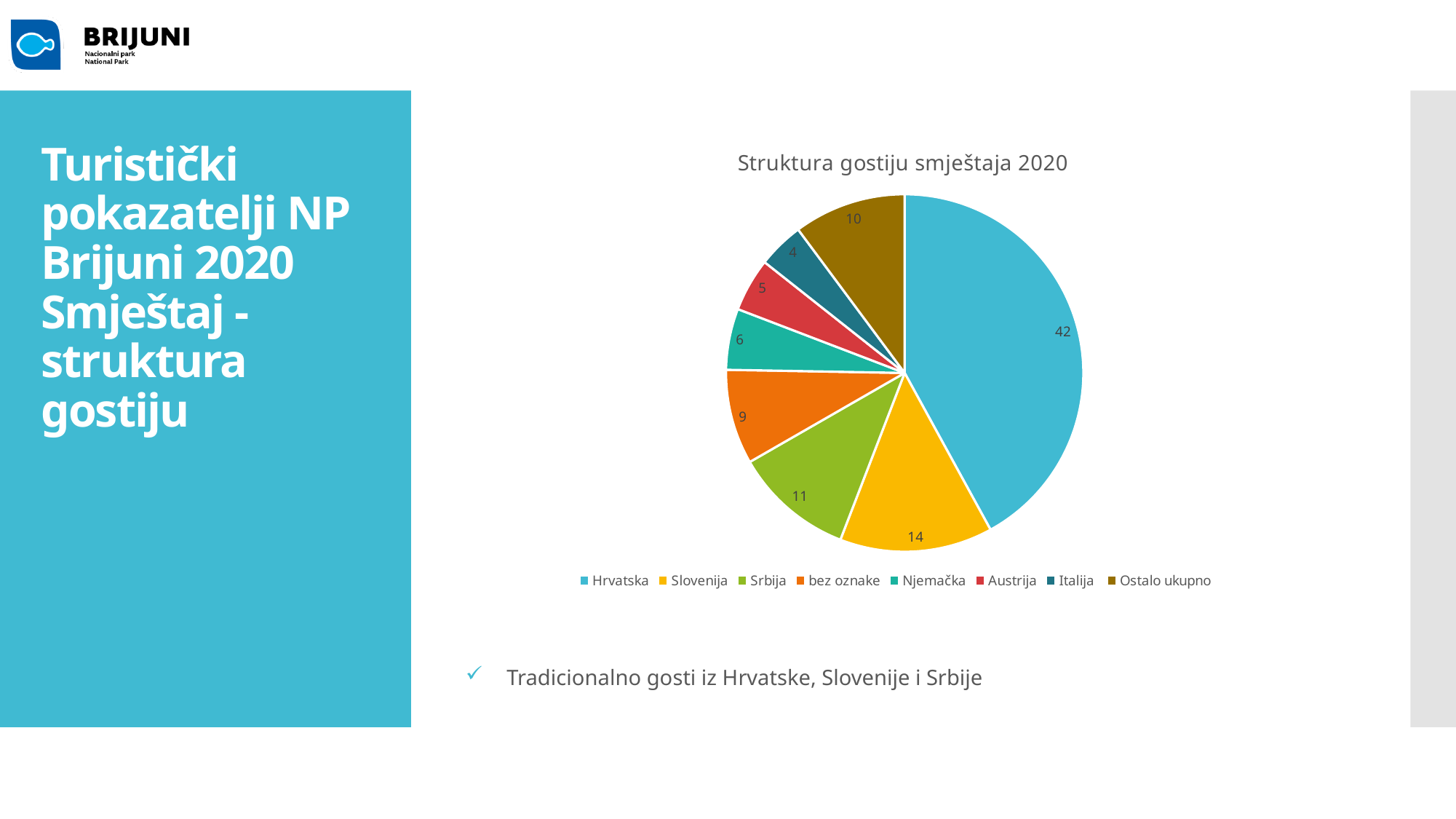
What is the value for Hrvatska? 42 What type of chart is shown on the slide? pie chart What is the value for bez oznake? 9 What is the title of the chart? Struktura gostiju smještaja 2020 How many categories does the pie chart have? 8 Which category has the largest slice? Hrvatska Which is larger, the value for Srbija or the value for Ostalo ukupno? Srbija What is the value for Ostalo ukupno? 10 What is the value for Slovenija? 14 What is the difference between the values for Njemačka and Austrija? 1 What is the difference between the values for Hrvatska and Slovenija? 28 Which category has the smallest slice? Italija